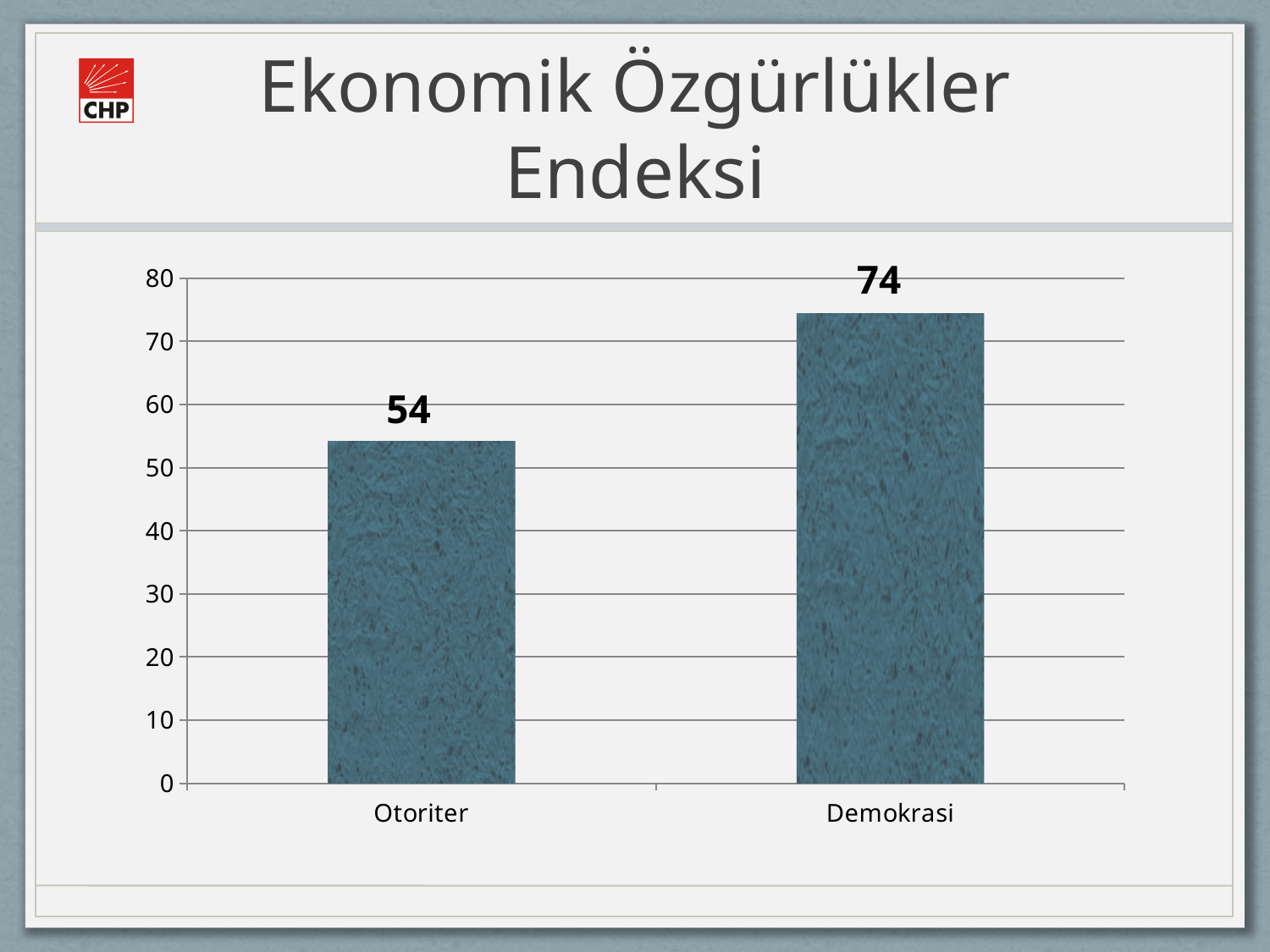
Which is larger, the value for Otoriter or the value for Demokrasi? Demokrasi What kind of chart is shown on the slide? bar chart Which category has the lowest value? Otoriter How many categories are shown on the x axis? 2 What is the difference between the values for Demokrasi and Otoriter? 20 What is the highest value shown on the y axis? 80 Is the value for Otoriter greater or less than 60? less Which category has the highest value? Demokrasi Is the value for Demokrasi greater or less than 70? greater What is the value for Otoriter? 54 What is the title of the slide? Ekonomik Özgürlükler Endeksi What is the value for Demokrasi? 74